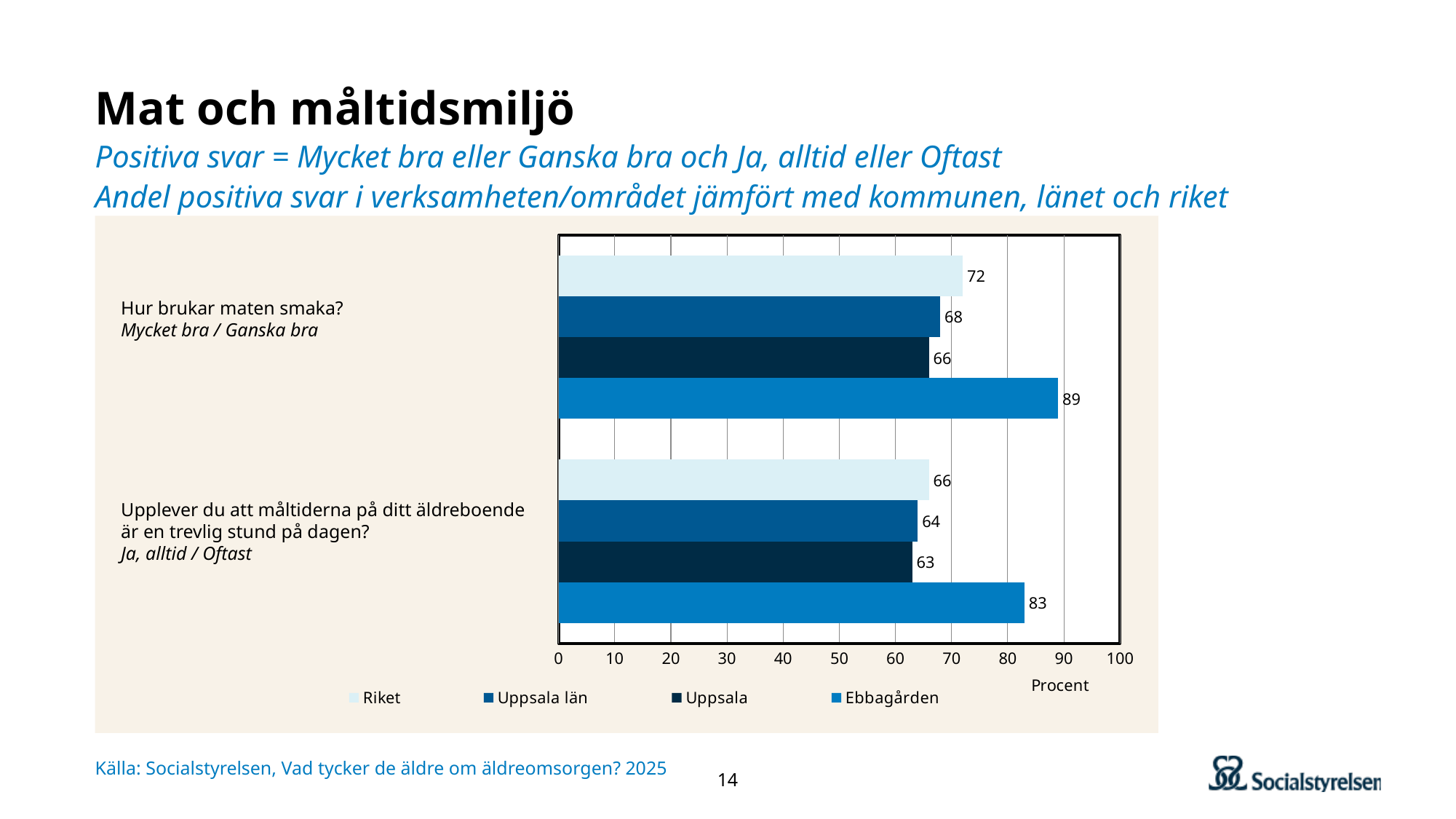
Which series has the lowest value on the question "Upplever du att måltiderna på ditt äldreboende är en trevlig stund på dagen?"? Uppsala What kind of chart is shown on the slide? Bar chart What is the difference between Ebbagården and Uppsala on the question "Upplever du att måltiderna på ditt äldreboende är en trevlig stund på dagen?"? 20 What is the value for Ebbagården on the question "Hur brukar maten smaka?"? 89 Which series has the highest value on the question "Hur brukar maten smaka?"? Ebbagården What is the value for Riket on the question "Upplever du att måltiderna på ditt äldreboende är en trevlig stund på dagen?"? 66 How many series does the legend list? 4 Which is larger: Riket on "Hur brukar maten smaka?" or Riket on "Upplever du att måltiderna på ditt äldreboende är en trevlig stund på dagen?"? Riket on "Hur brukar maten smaka?" What is the difference between Ebbagården and Riket on the question "Hur brukar maten smaka?"? 17 What is the label of the x axis? Procent What is the value for Uppsala on the question "Upplever du att måltiderna på ditt äldreboende är en trevlig stund på dagen?"? 63 What is the value for Uppsala län on the question "Hur brukar maten smaka?"? 68